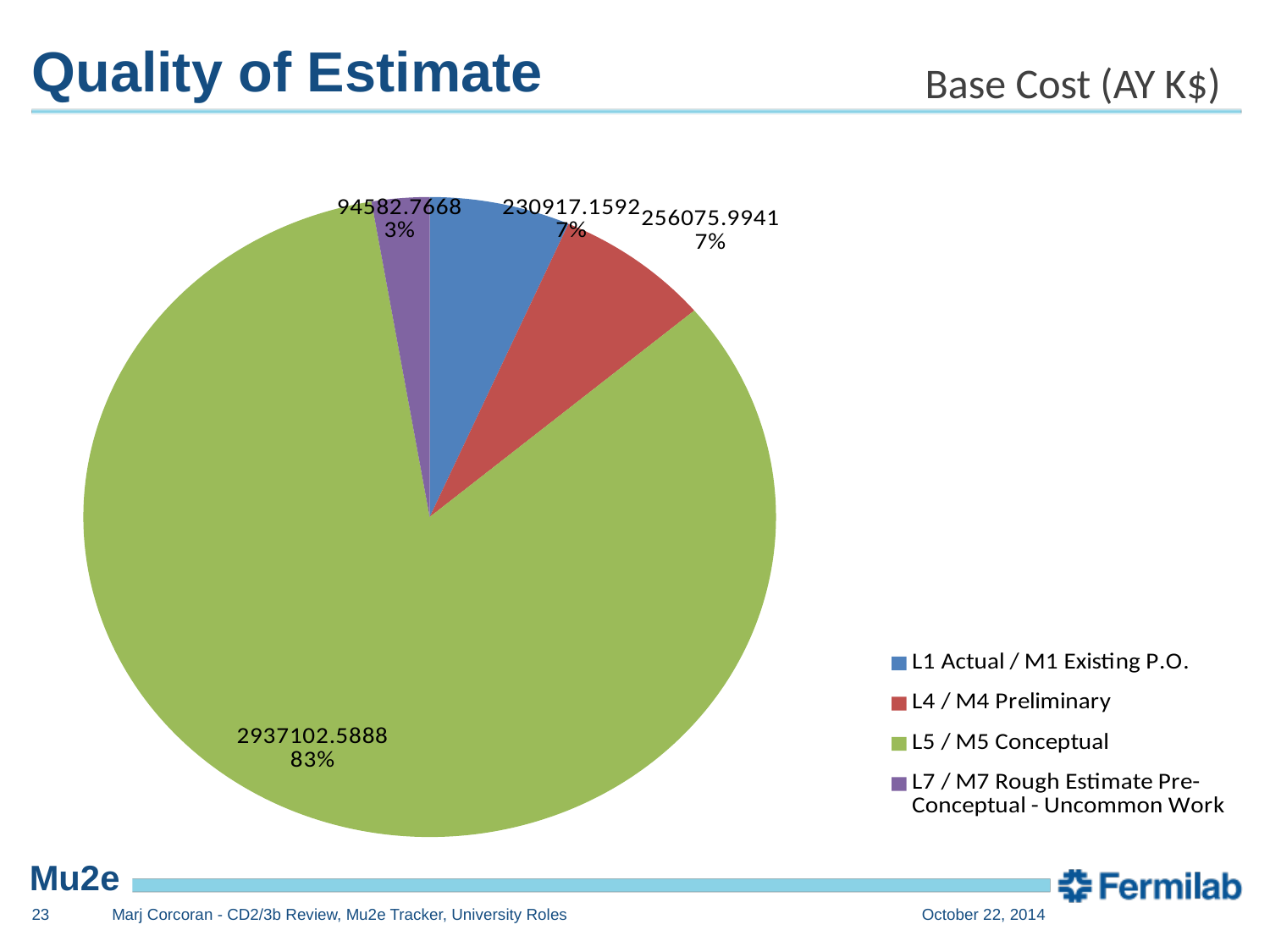
What share of the pie does L7 / M7 Rough Estimate Pre-Conceptual - Uncommon Work represent? 3% What is the value for L4 / M4 Preliminary? 256075.9941 What kind of chart is shown on the slide? pie chart What is the value for L1 Actual / M1 Existing P.O.? 230917.1592 What share of the pie does L5 / M5 Conceptual represent? 83% What is the value for L7 / M7 Rough Estimate Pre-Conceptual - Uncommon Work? 94582.7668 What is the value for L5 / M5 Conceptual? 2937102.5888 Which category has the largest slice of the pie? L5 / M5 Conceptual How many slices does the pie chart have? 4 How many entries does the legend list? 4 Which category has the smallest slice of the pie? L7 / M7 Rough Estimate Pre-Conceptual - Uncommon Work